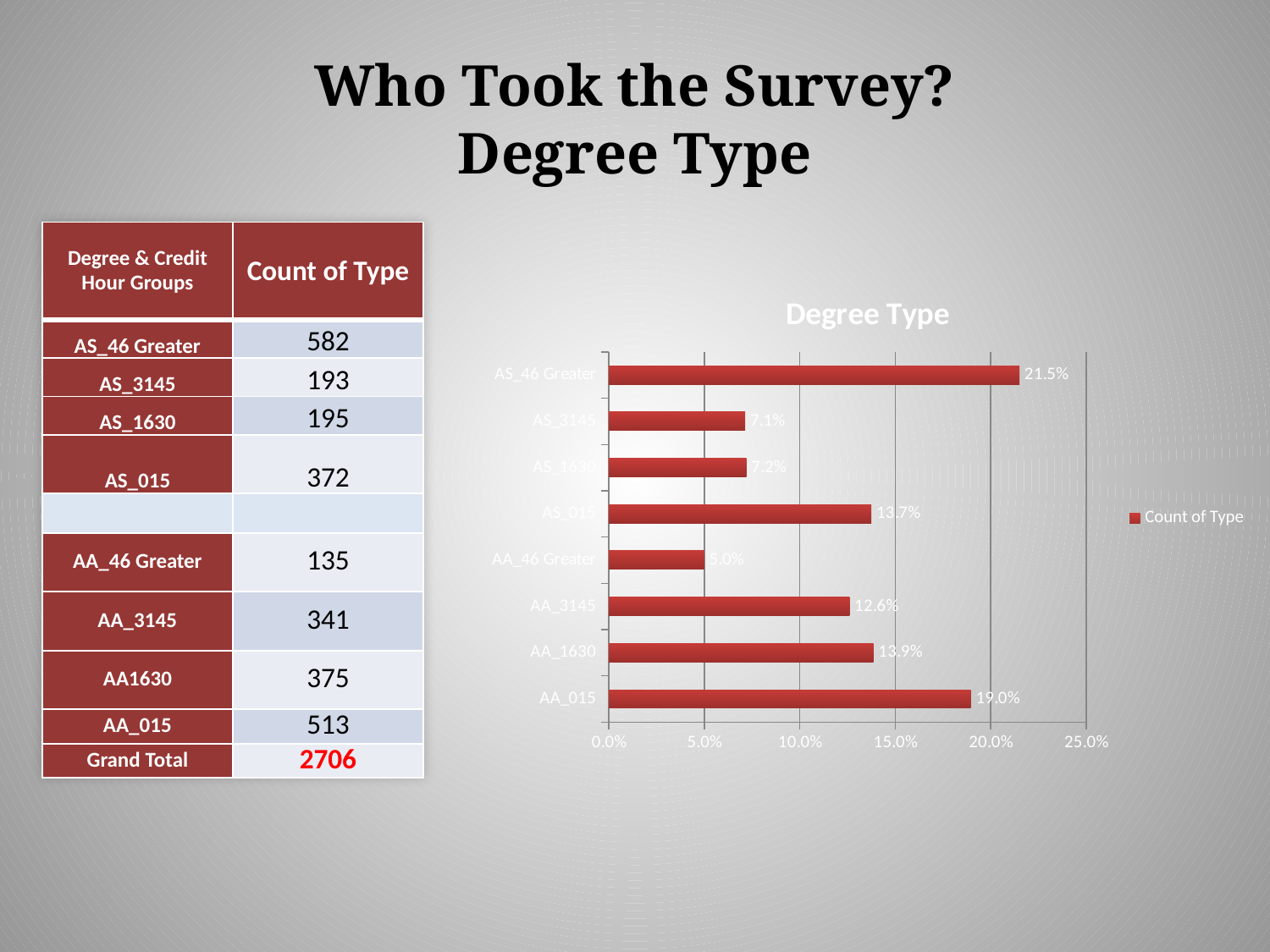
In the Degree Type chart, what is the value for AS_46 Greater? 21.5% What kind of chart is the Degree Type chart? bar chart In the Degree Type chart, which category has the lowest value? AA_46 Greater In the Degree Type chart, what is the value for AA_015? 19.0% How many categories are shown in the Degree Type chart? 8 What series name does the legend of the Degree Type chart show? Count of Type In the Degree Type chart, which is larger, the value for AA_3145 or the value for AA_1630? AA_1630 In the Degree Type chart, what is the difference between the values for AS_46 Greater and AA_015? 2.5% In the Degree Type chart, which category has the highest value? AS_46 Greater In the Degree Type chart, what is the value for AA_46 Greater? 5.0% In the Degree Type chart, is the value for AS_015 greater or less than 10.0%? greater In the Degree Type chart, what is the value for AS_015? 13.7%